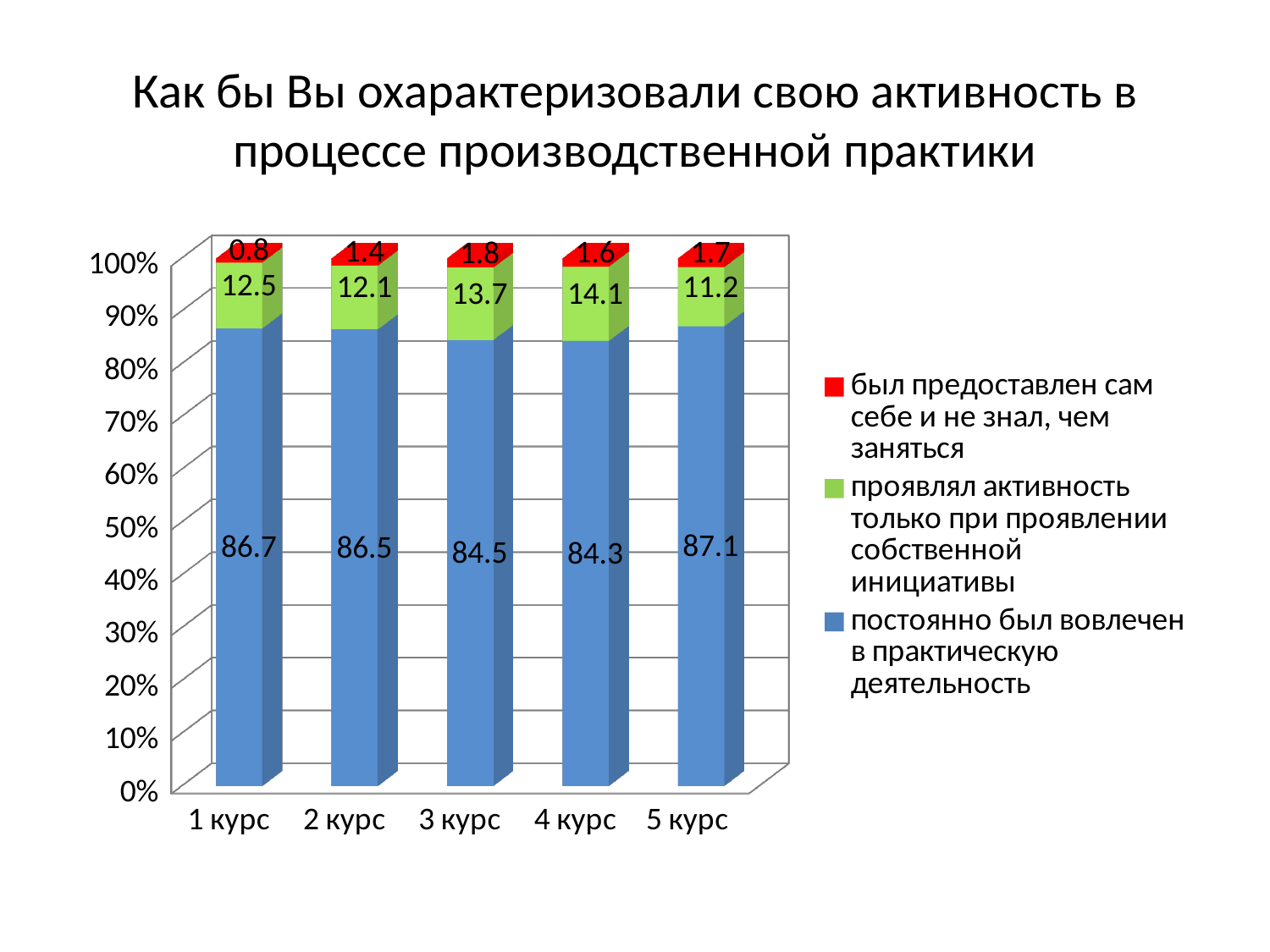
What value is shown for "постоянно был вовлечен в практическую деятельность" for 3 курс? 84.5 Which course has the highest value for "постоянно был вовлечен в практическую деятельность"? 5 курс Which course has the lowest value for "был предоставлен сам себе и не знал, чем заняться"? 1 курс What value is shown for "был предоставлен сам себе и не знал, чем заняться" for 1 курс? 0.8 How many series does the legend list? 3 Which course has the lowest value for "проявлял активность только при проявлении собственной инициативы"? 5 курс What value is shown for "проявлял активность только при проявлении собственной инициативы" for 4 курс? 14.1 How many courses (categories) are shown on the x axis? 5 Which colour represents "был предоставлен сам себе и не знал, чем заняться" in the legend? Red What is the difference between the "постоянно был вовлечен в практическую деятельность" values for 5 курс and 4 курс? 2.8 What kind of chart is shown on the slide? Stacked bar chart Which is larger: the "проявлял активность только при проявлении собственной инициативы" value for 3 курс or for 2 курс? 3 курс